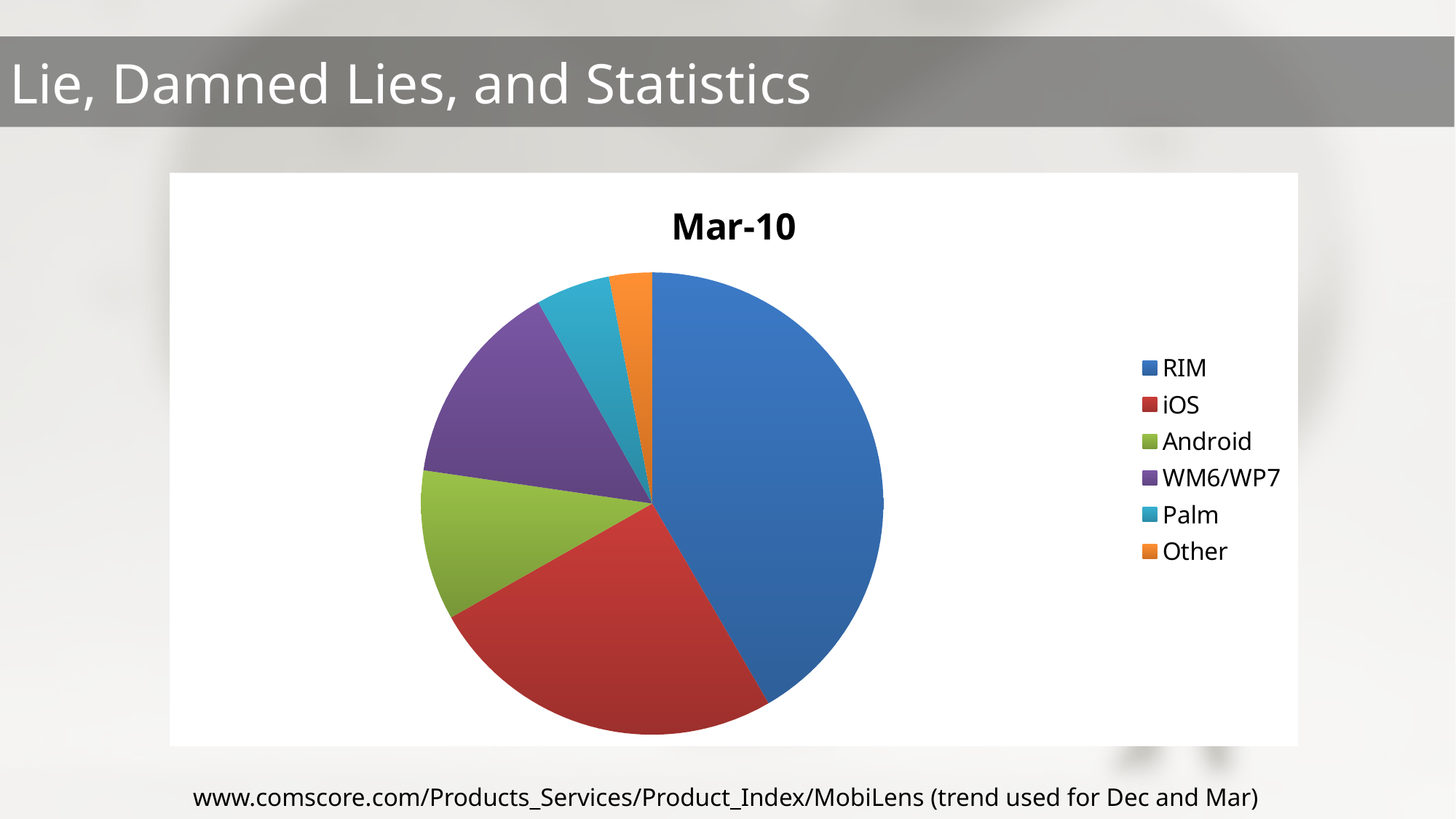
Which category has the largest slice of the pie? RIM Which slice is larger, Android or WM6/WP7? WM6/WP7 Which slice is larger, WM6/WP7 or Palm? WM6/WP7 Which slice is larger, RIM or iOS? RIM How many slices does the pie chart have? 6 Which category has the smallest slice of the pie? Other What is the title of the chart? Mar-10 Which colour represents iOS in the pie chart? red How many entries does the legend list? 6 What kind of chart is shown on the slide? pie chart